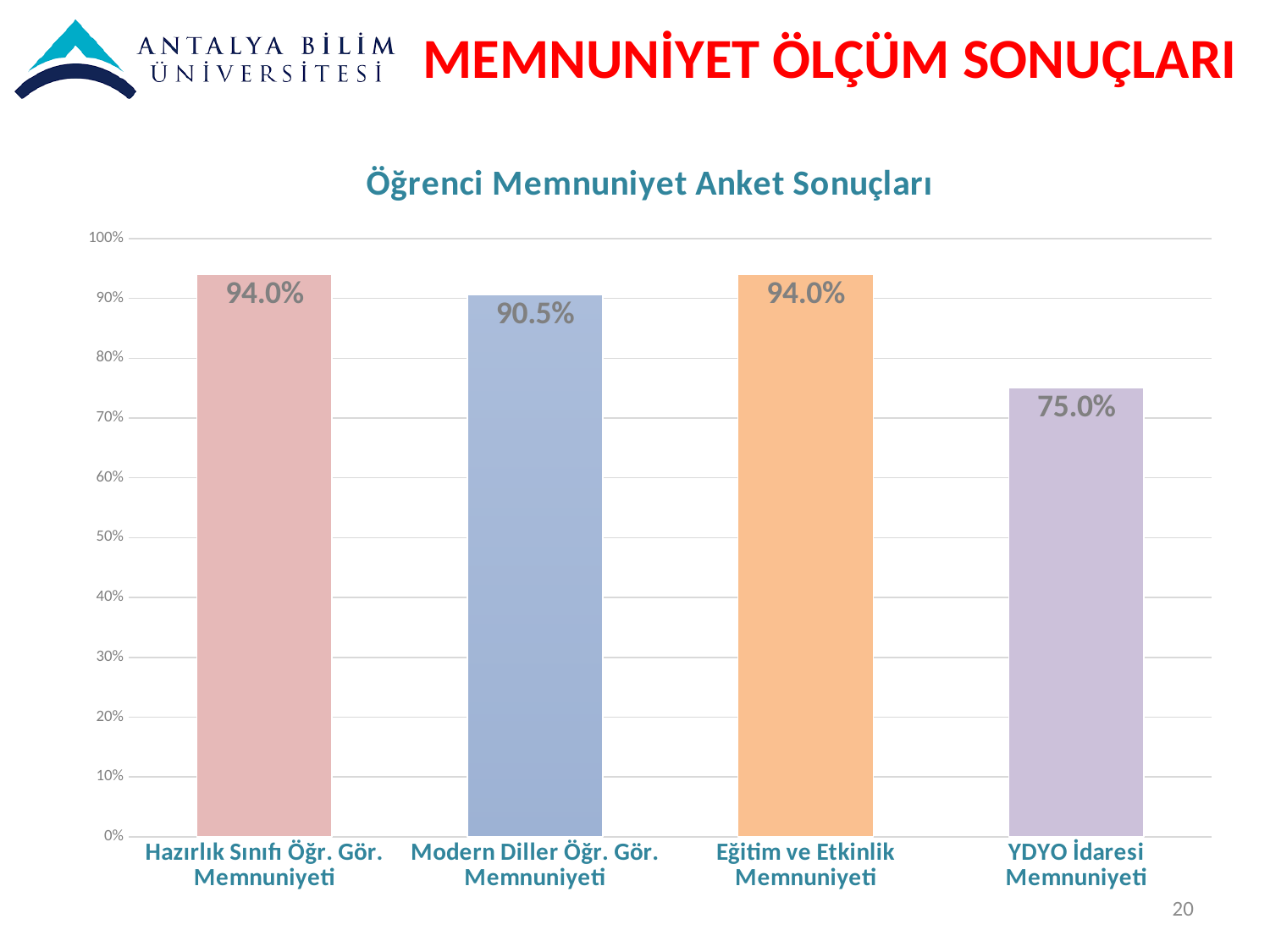
What is the value for YDYO İdaresi Memnuniyeti? 75.0% What is the value for Hazırlık Sınıfı Öğr. Gör. Memnuniyeti? 94.0% What is the value for Eğitim ve Etkinlik Memnuniyeti? 94.0% What is the title of the chart? Öğrenci Memnuniyet Anket Sonuçları What is the difference between Eğitim ve Etkinlik Memnuniyeti and Modern Diller Öğr. Gör. Memnuniyeti? 3.5% What kind of chart is shown on the slide? Bar chart What is the difference between Hazırlık Sınıfı Öğr. Gör. Memnuniyeti and YDYO İdaresi Memnuniyeti? 19.0% Which category has the lowest value? YDYO İdaresi Memnuniyeti How many categories are shown in the chart? 4 What is the value for Modern Diller Öğr. Gör. Memnuniyeti? 90.5% Is the value for YDYO İdaresi Memnuniyeti greater or less than 80%? less Which is larger, Modern Diller Öğr. Gör. Memnuniyeti or YDYO İdaresi Memnuniyeti? Modern Diller Öğr. Gör. Memnuniyeti